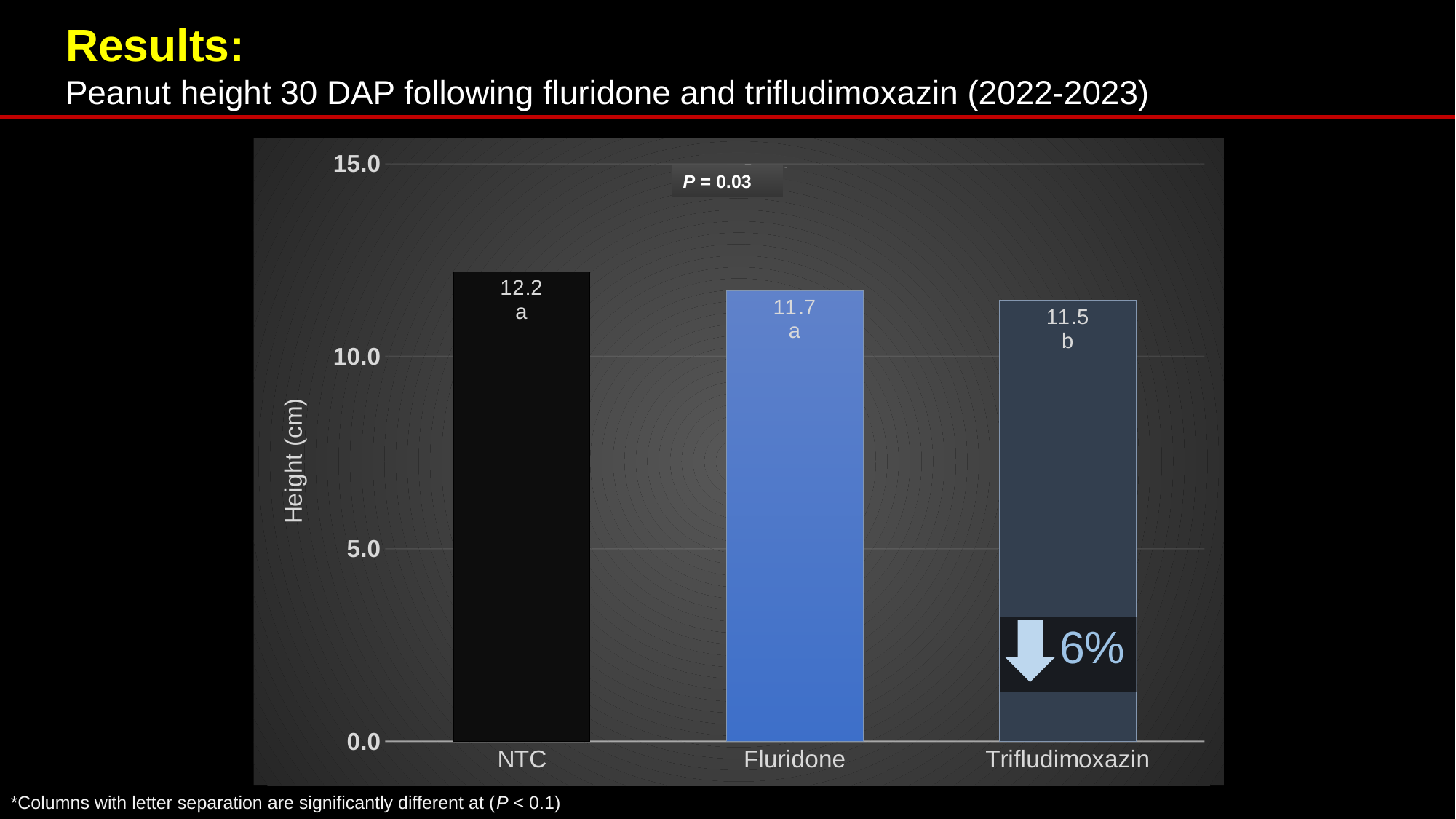
Which treatment has the greatest peanut height? NTC What P value is printed on the chart? P = 0.03 What is the height value for NTC? 12.2 What is the height value for Fluridone? 11.7 Which has a larger height value, Fluridone or Trifludimoxazin? Fluridone What is the height value for Trifludimoxazin? 11.5 What is the difference in height between NTC and Fluridone? 0.5 How many treatments are shown on the x axis? 3 What is the difference in height between NTC and Trifludimoxazin? 0.7 What kind of chart is shown on the slide? Bar chart Is the value for Trifludimoxazin greater or less than 10.0? greater Which treatment has the lowest peanut height? Trifludimoxazin